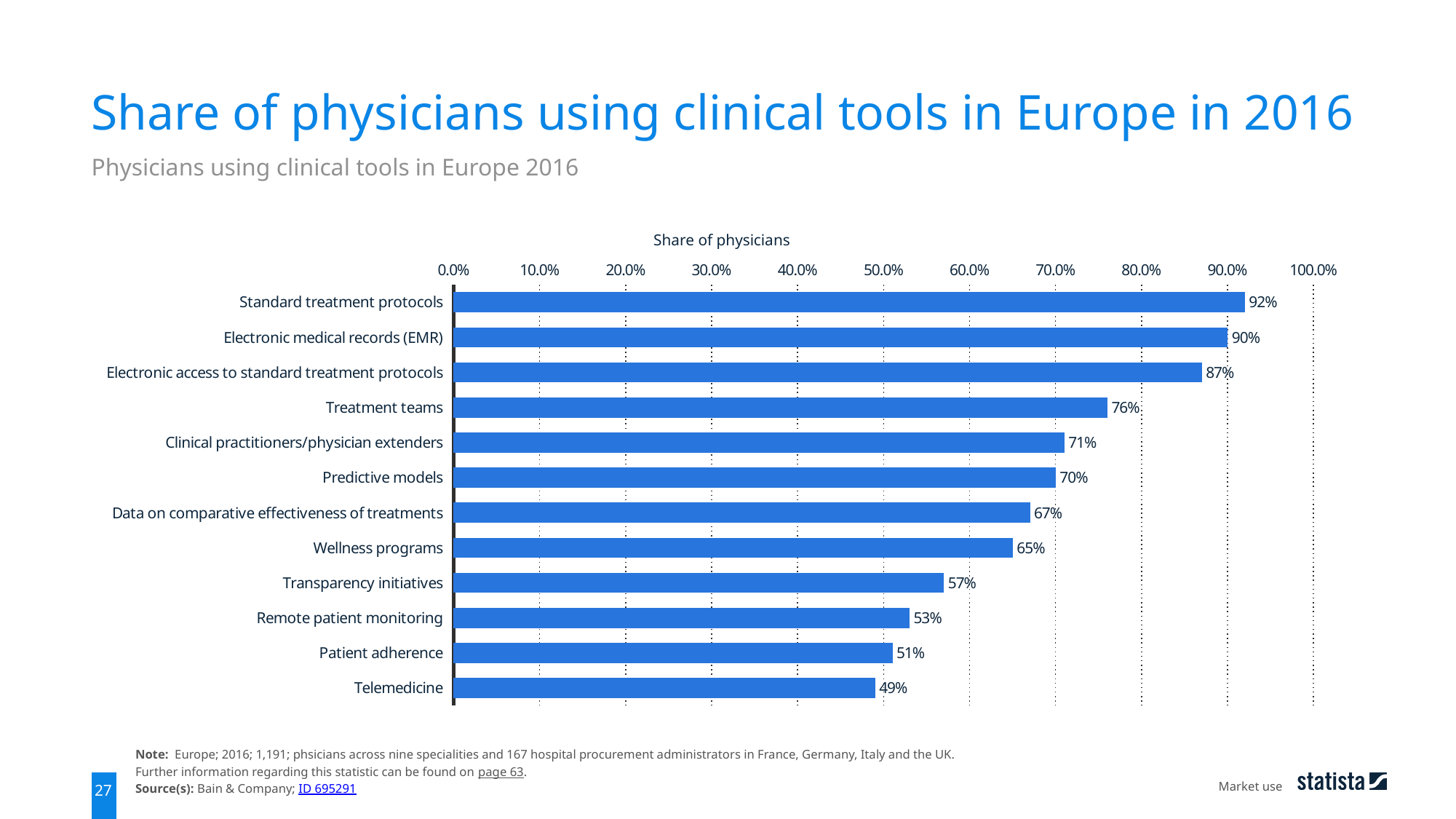
What is the label of the value axis of the chart? Share of physicians How many clinical tools are shown in the chart? 12 What is the difference in share between treatment teams and predictive models? 6% What is the share of physicians using wellness programs? 65% Which has a larger share of physicians: remote patient monitoring or transparency initiatives? Transparency initiatives What is the share of physicians using telemedicine? 49% Which clinical tool has the highest share of physicians using it? Standard treatment protocols Is the share for clinical practitioners/physician extenders greater or less than 60.0%? greater What is the difference in share between standard treatment protocols and telemedicine? 43% Which clinical tool has the lowest share of physicians using it? Telemedicine What kind of chart is shown on the slide? Bar chart What is the share of physicians using electronic medical records (EMR)? 90%